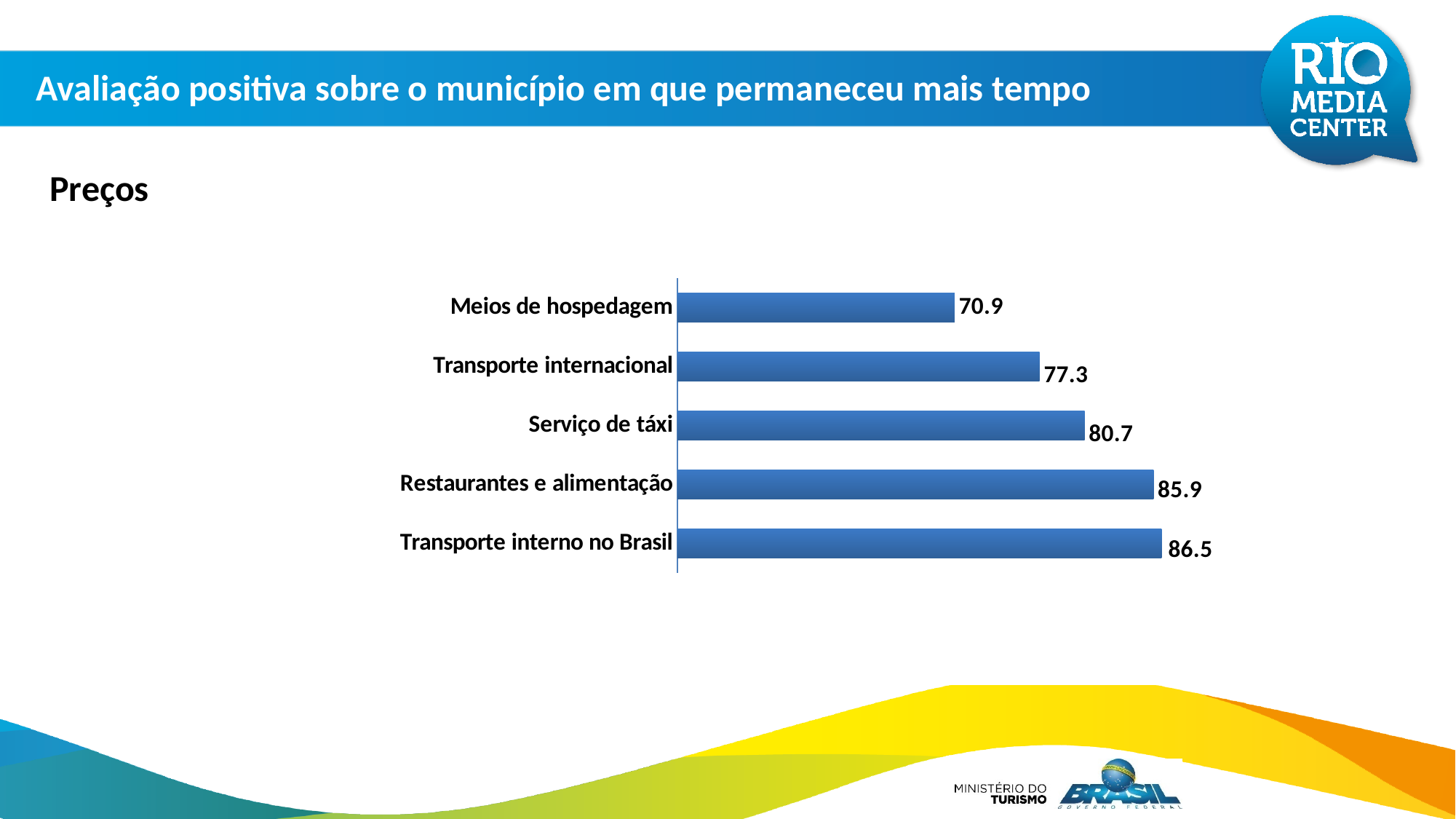
What is the value for Serviço de táxi? 80.7 How many categories are shown in the chart? 5 Which category has the lowest value? Meios de hospedagem What is the difference between the values for Transporte interno no Brasil and Meios de hospedagem? 15.6 What is the difference between the values for Serviço de táxi and Transporte internacional? 3.4 What is the value for Transporte interno no Brasil? 86.5 What is the value for Restaurantes e alimentação? 85.9 Which category has the highest value? Transporte interno no Brasil What kind of chart is shown on the slide? Bar chart Which is larger, the value for Serviço de táxi or the value for Transporte internacional? Serviço de táxi What is the value for Meios de hospedagem? 70.9 What is the value for Transporte internacional? 77.3